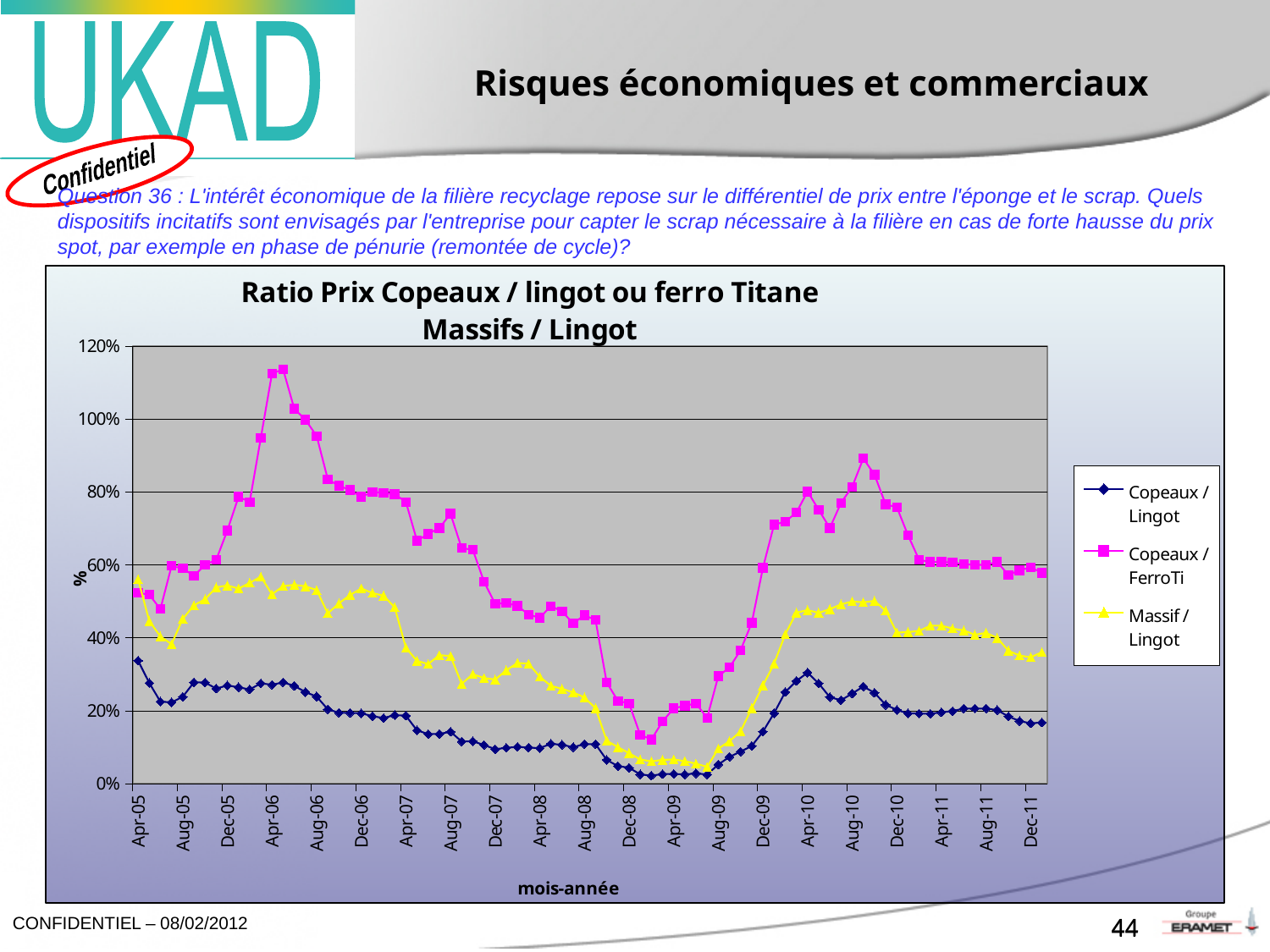
Which series reaches the highest value on the chart? Copeaux / FerroTi What is the label of the x axis? mois-année How many series does the legend list? 3 Does the Copeaux / FerroTi series rise or fall between Apr-06 and Dec-08? fall What kind of chart is shown on the slide? line chart Which series has the lowest values across the chart? Copeaux / Lingot Is the value for Copeaux / FerroTi at Apr-06 greater or less than 100%? greater At Apr-06, which is larger: Copeaux / FerroTi or Massif / Lingot? Copeaux / FerroTi Is the value for Copeaux / Lingot at Apr-09 greater or less than 20%? less Is the value for Copeaux / FerroTi at Dec-08 greater or less than 40%? less What is the title of the chart? Ratio Prix Copeaux / lingot ou ferro Titane Massifs / Lingot